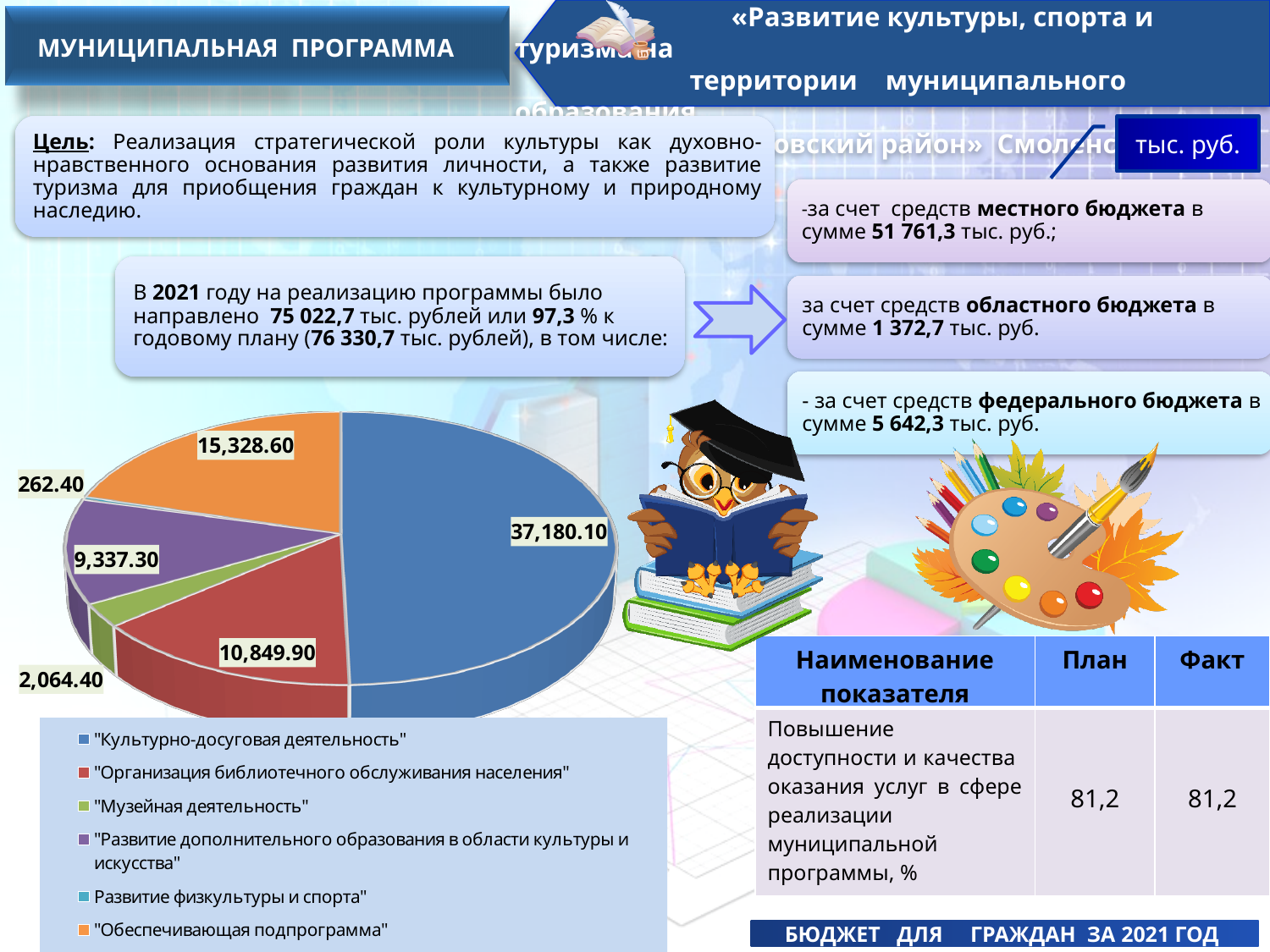
Which is larger in the pie chart: "Обеспечивающая подпрограмма" or "Развитие дополнительного образования в области культуры и искусства"? "Обеспечивающая подпрограмма" What is the value for "Обеспечивающая подпрограмма" in the pie chart? 15,328.60 What is the value for "Музейная деятельность" in the pie chart? 2,064.40 What colour is the slice for "Развитие дополнительного образования в области культуры и искусства" in the pie chart? purple How many categories does the legend of the pie chart list? 6 What is the value for "Организация библиотечного обслуживания населения" in the pie chart? 10,849.90 What is the difference between the values for "Культурно-досуговая деятельность" and "Организация библиотечного обслуживания населения" in the pie chart? 26,330.20 What is the value for "Культурно-досуговая деятельность" in the pie chart? 37,180.10 What is the value for "Развитие физкультуры и спорта" in the pie chart? 262.40 What type of chart is shown on the slide? pie chart Which category has the smallest slice in the pie chart? Развитие физкультуры и спорта Which category has the largest slice in the pie chart? "Культурно-досуговая деятельность"